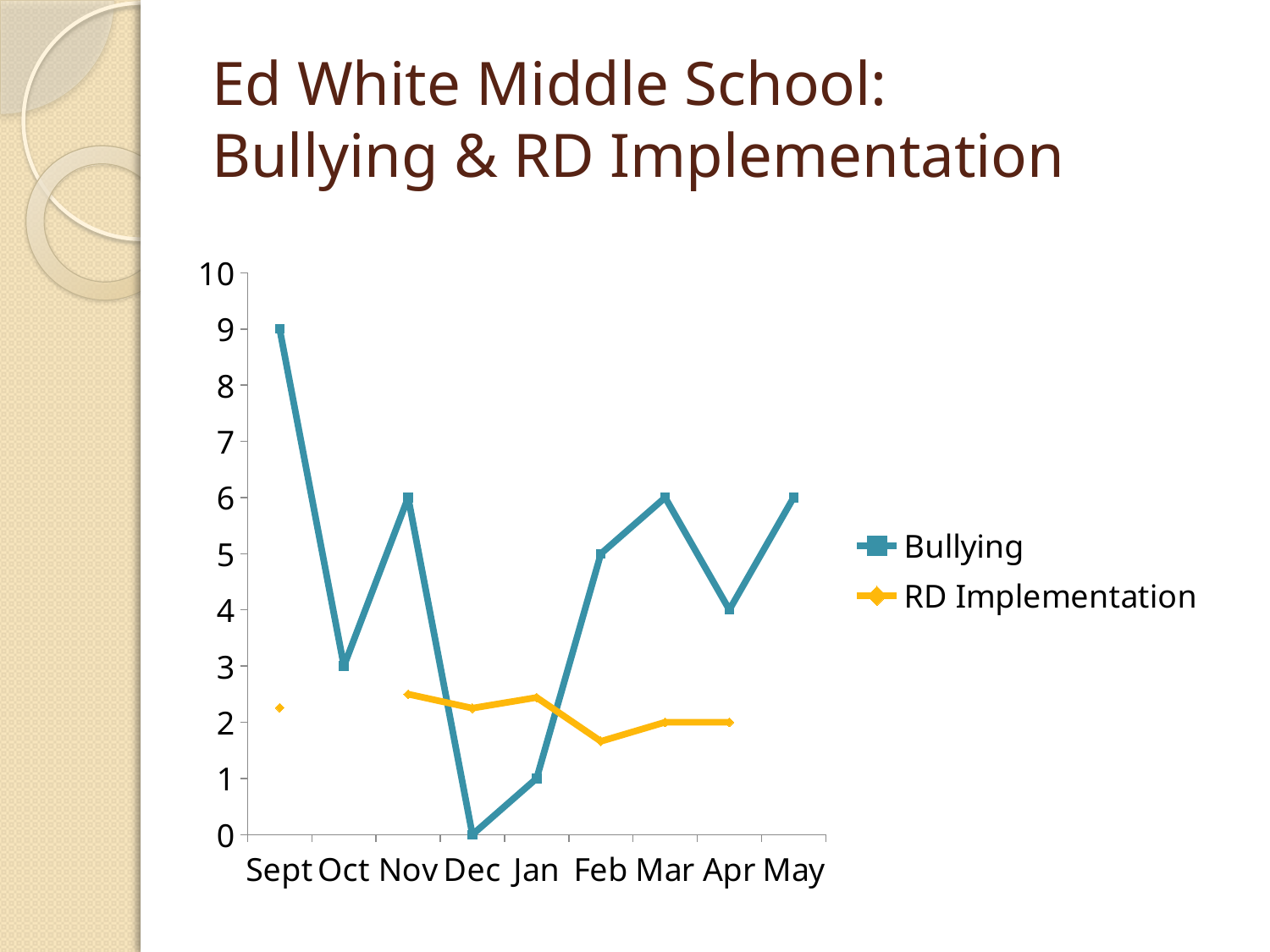
What type of chart is shown on the slide? line chart How many series does the legend list? 2 In which month is the Bullying value highest? Sept Is the RD Implementation value for Sept greater or less than 3? less What is the Bullying value for Sept? 9 Which is larger, the Bullying value for Nov or for Oct? Nov Does the Bullying line rise or fall from Sept to Dec? fall How many months are shown on the x axis? 9 What is the Bullying value for Dec? 0 What is the Bullying value for Feb? 5 What is the difference between the Bullying values for Sept and Oct? 6 In which month is the Bullying value lowest? Dec